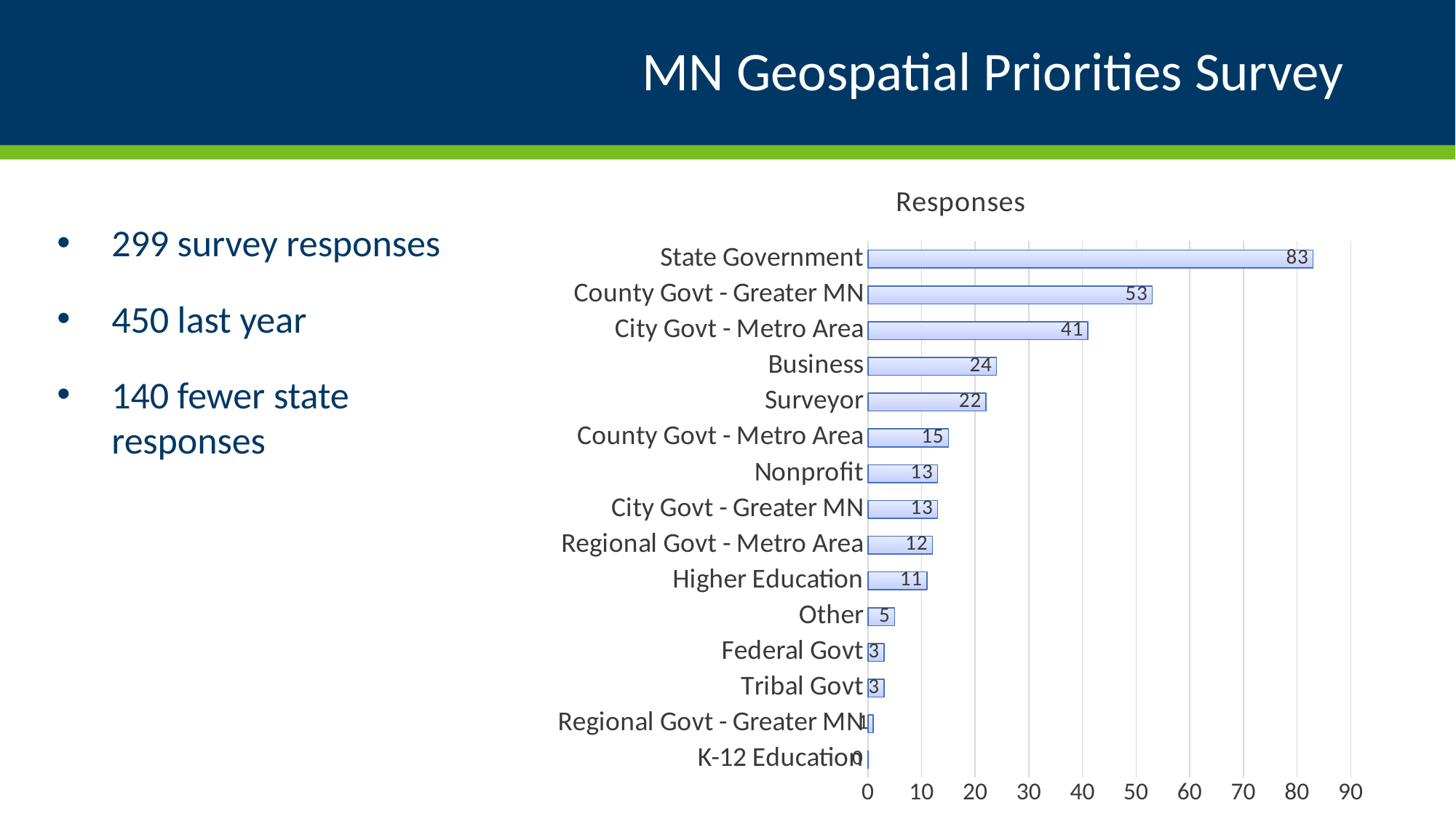
How many categories are shown in the chart? 15 Which category has the highest value? State Government What is the title of the chart? Responses What is the value for Surveyor? 22 What kind of chart is shown? Bar chart What is the value for Higher Education? 11 What is the value for County Govt - Greater MN? 53 Which is larger, Business or City Govt - Metro Area? City Govt - Metro Area What is the value for State Government? 83 Which category has the lowest value? K-12 Education What is the difference between State Government and County Govt - Greater MN? 30 What is the difference between Business and Surveyor? 2